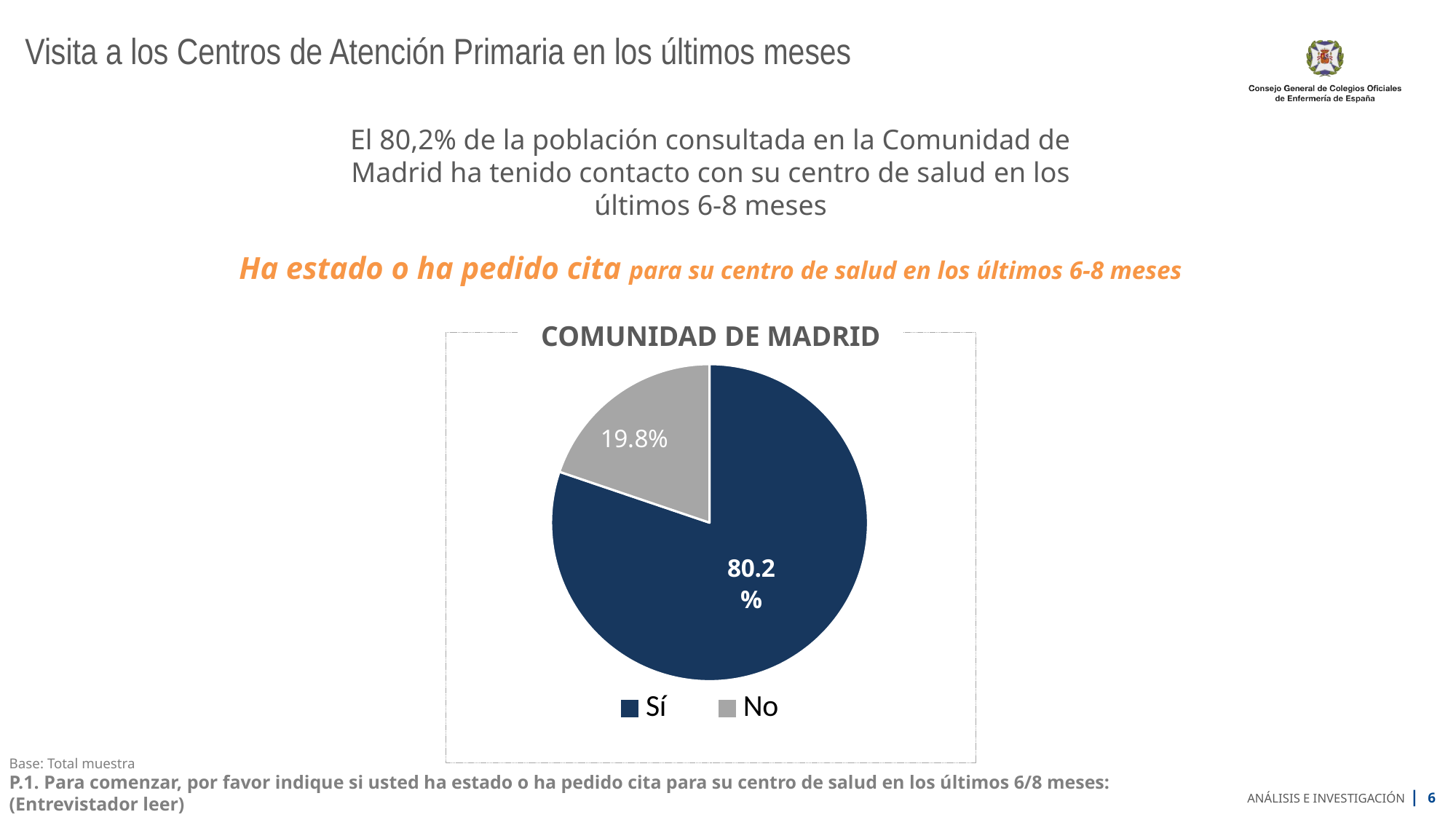
What percentage of respondents answered "No"? 19.8% What percentage of respondents answered "Sí"? 80.2% What type of chart is shown on the slide? Pie chart Which is larger, the "Sí" slice or the "No" slice? Sí How many entries does the legend list? 2 What colour is the "No" slice? Grey Which category has the smallest share of the pie? No What is the title of the chart? COMUNIDAD DE MADRID What share of the pie does the "Sí" slice represent? 80.2% How many slices does the pie chart have? 2 Which category has the largest share of the pie? Sí What is the difference in percentage points between the "Sí" and "No" slices? 60.4